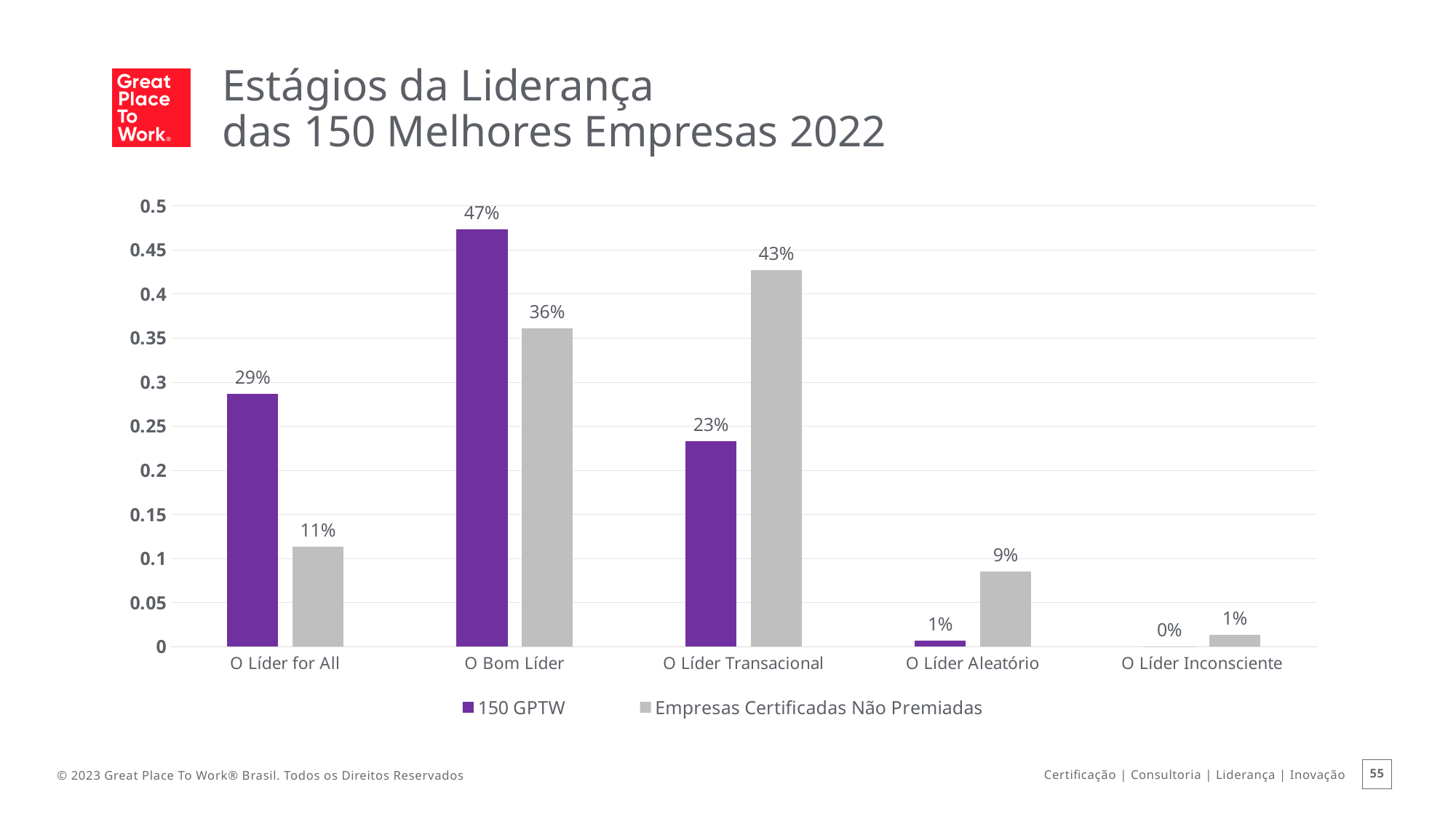
What is the value for Empresas Certificadas Não Premiadas in the O Líder for All category? 11% What kind of chart is shown on the slide? Bar chart For O Líder Transacional, which series has the larger value: 150 GPTW or Empresas Certificadas Não Premiadas? Empresas Certificadas Não Premiadas Which category has the lowest value for the Empresas Certificadas Não Premiadas series? O Líder Inconsciente Which category has the highest value for the 150 GPTW series? O Bom Líder What is the value for Empresas Certificadas Não Premiadas in the O Líder Transacional category? 43% What is the value for 150 GPTW in the O Bom Líder category? 47% What is the difference between the 150 GPTW and Empresas Certificadas Não Premiadas values for O Líder for All? 18% How many series does the legend list? 2 What colour are the bars for the 150 GPTW series? Purple How many categories are shown on the x axis? 5 Is the value for 150 GPTW in O Líder for All greater or less than 0.25? greater